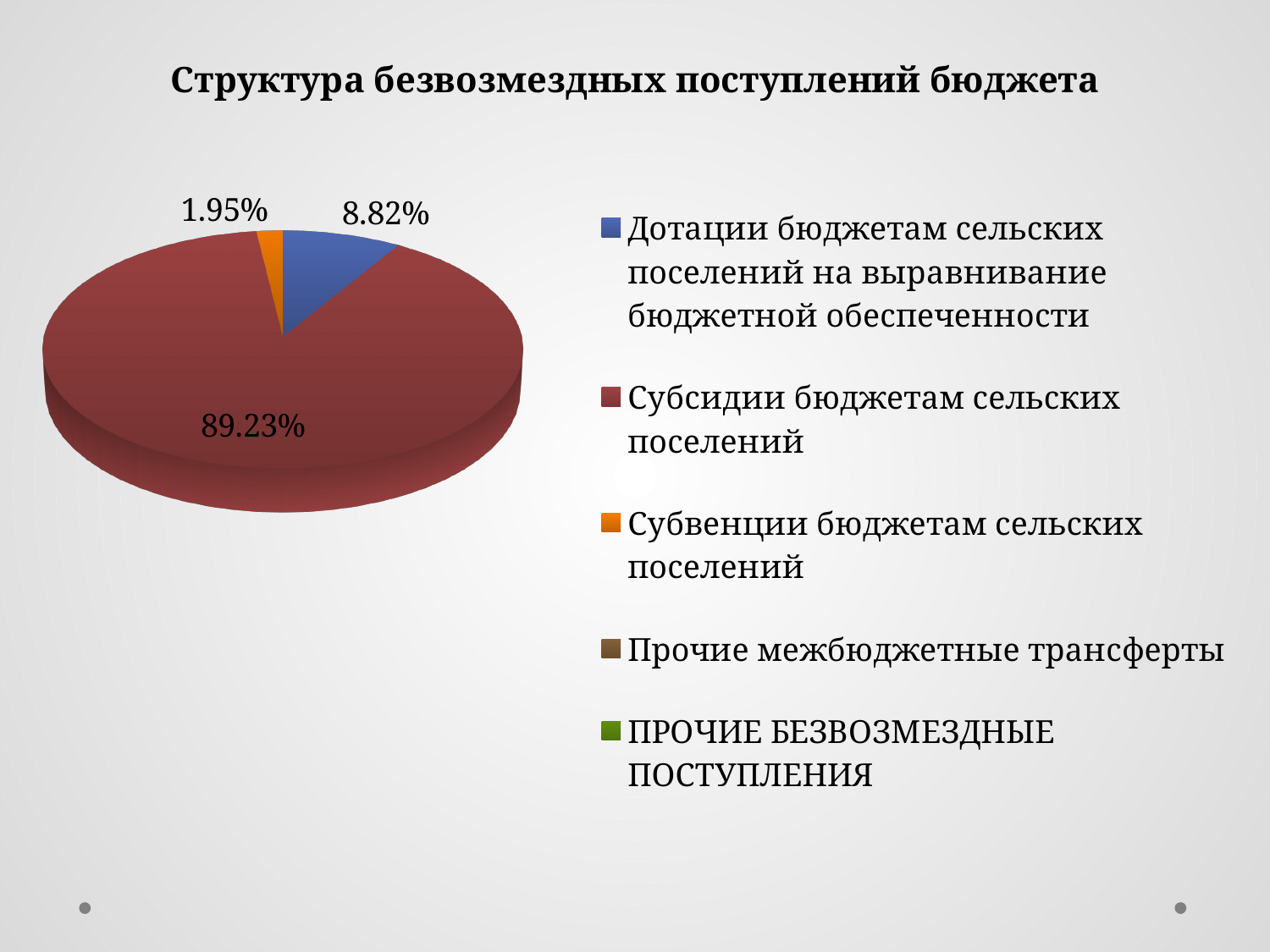
What share of the pie is labelled for Субвенции бюджетам сельских поселений? 1.95% What is the difference in percentage points between the Субсидии slice and the Дотации slice? 80.41 How many slices have a percentage label on the pie? 3 Which category has the largest slice of the pie? Субсидии бюджетам сельских поселений Which of the labelled slices is the smallest? Субвенции бюджетам сельских поселений What is the difference in percentage points between the Дотации slice and the Субвенции slice? 6.87 Which is larger: the Дотации slice or the Субвенции slice? Дотации бюджетам сельских поселений на выравнивание бюджетной обеспеченности What is the title of the chart? Структура безвозмездных поступлений бюджета What kind of chart is shown on the slide? Pie chart What share of the pie is labelled for Субсидии бюджетам сельских поселений? 89.23% How many entries does the legend list? 5 What share of the pie is labelled for Дотации бюджетам сельских поселений на выравнивание бюджетной обеспеченности? 8.82%